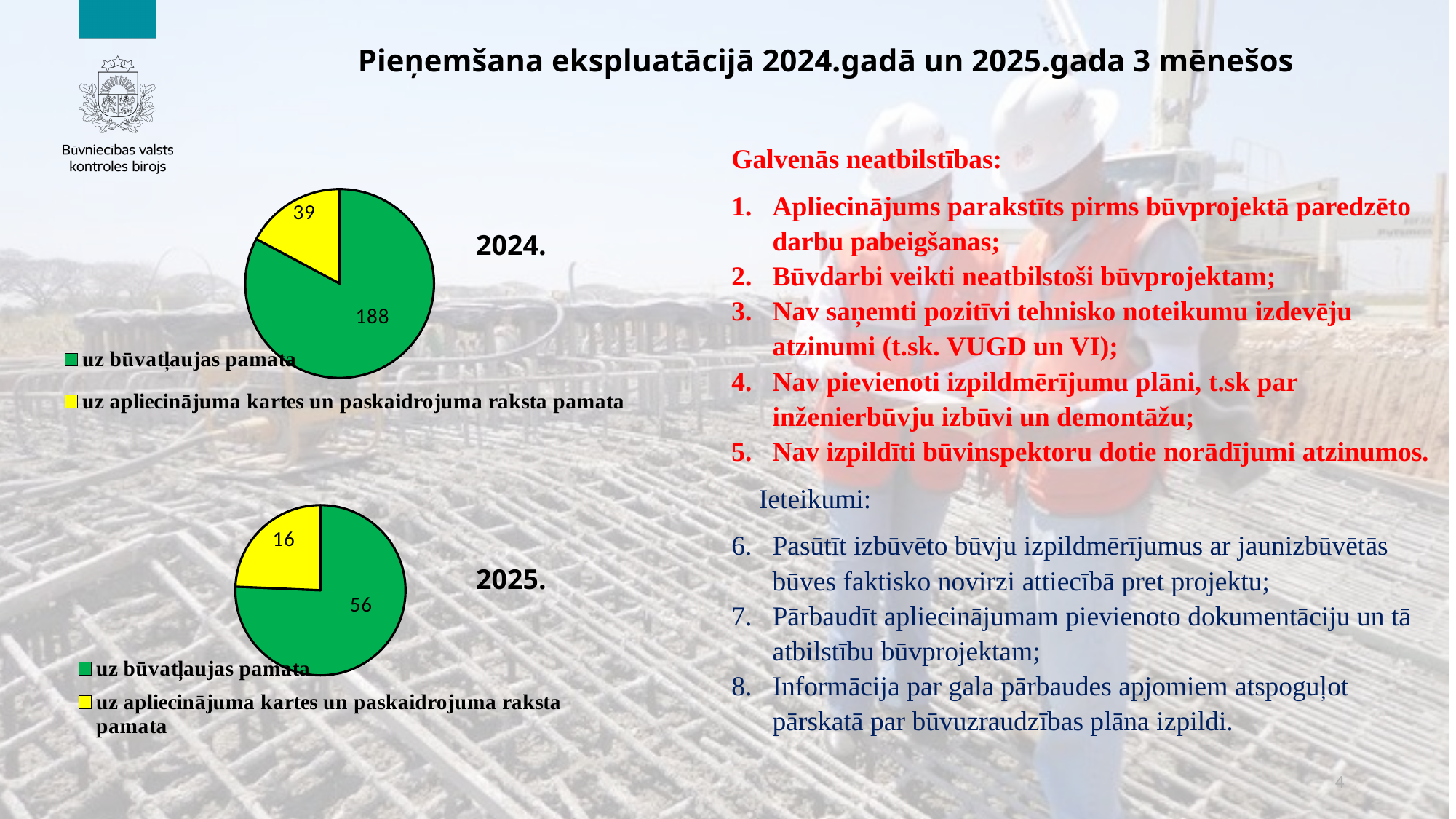
In the 2025 pie chart, what is the value for 'uz apliecinājuma kartes un paskaidrojuma raksta pamata'? 16 What type of chart is used for the 2024 data? pie chart How many categories does the 2025 pie chart show? 2 Which is larger: the 'uz būvatļaujas pamata' value in the 2024 chart or in the 2025 chart? 2024 In the 2025 pie chart, which category has the smallest slice? uz apliecinājuma kartes un paskaidrojuma raksta pamata In the 2024 pie chart, what is the value for 'uz apliecinājuma kartes un paskaidrojuma raksta pamata'? 39 In the 2024 pie chart, which category has the largest slice? uz būvatļaujas pamata In the 2025 pie chart, what is the value for 'uz būvatļaujas pamata'? 56 In the 2024 pie chart, what is the value for 'uz būvatļaujas pamata'? 188 In the 2024 pie chart, what is the difference between the two slice values? 149 In the 2024 pie chart, what colour is the 'uz apliecinājuma kartes un paskaidrojuma raksta pamata' slice? yellow In the 2025 pie chart, what is the difference between the two slice values? 40